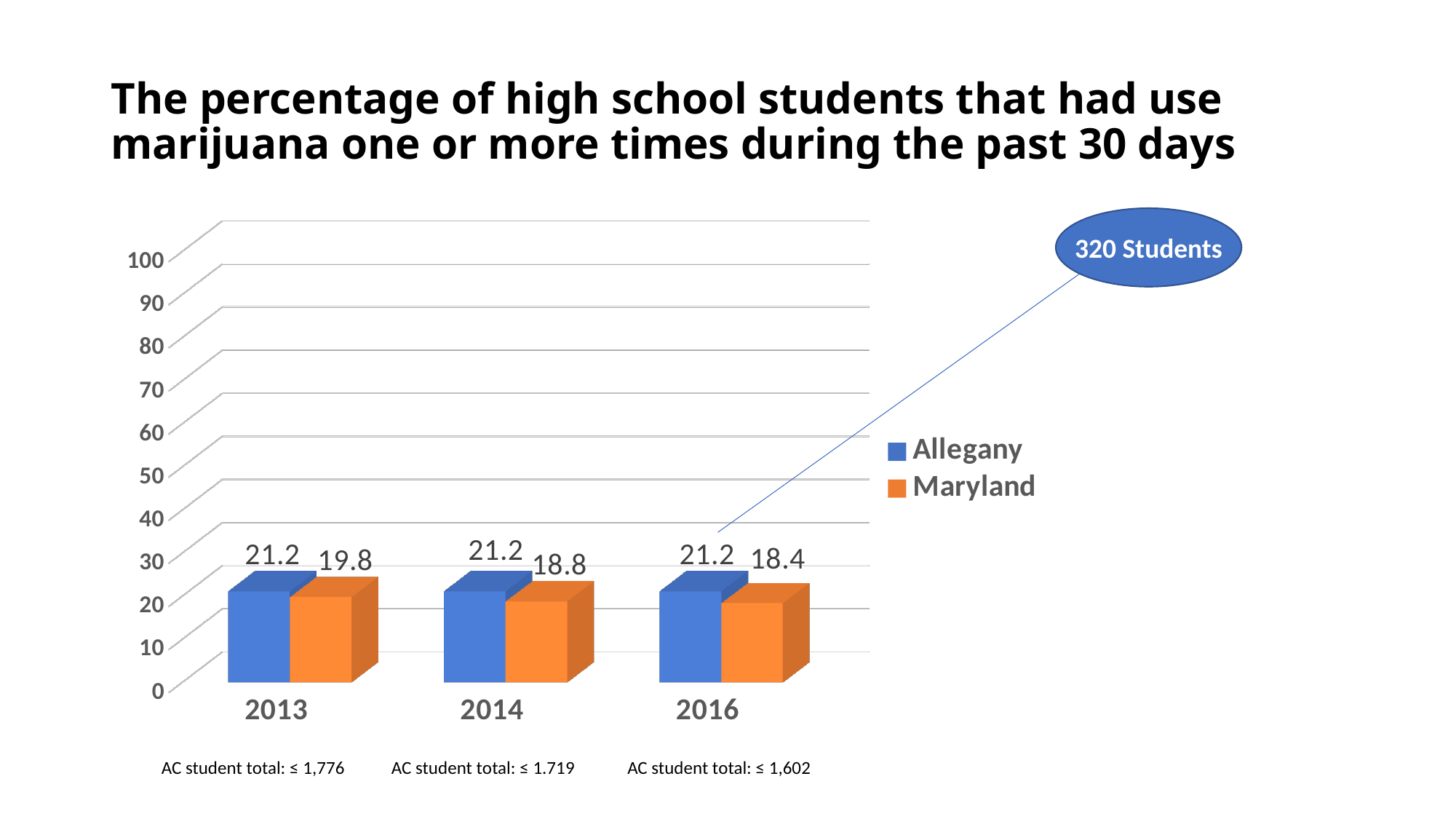
What is the value for Maryland in 2016? 18.4 Which year has the highest Maryland value? 2013 What is the difference between the Allegany and Maryland values in 2016? 2.8 Which is larger in 2013, the Allegany value or the Maryland value? Allegany How many years are shown on the x axis? 3 Do the Maryland values rise or fall from 2013 to 2016? Fall What kind of chart is shown on the slide? Bar chart Which year has the lowest Maryland value? 2016 What is the value for Maryland in 2014? 18.8 How many series does the legend list? 2 What is the value for Allegany in 2013? 21.2 What does the callout bubble on the slide say? 320 Students